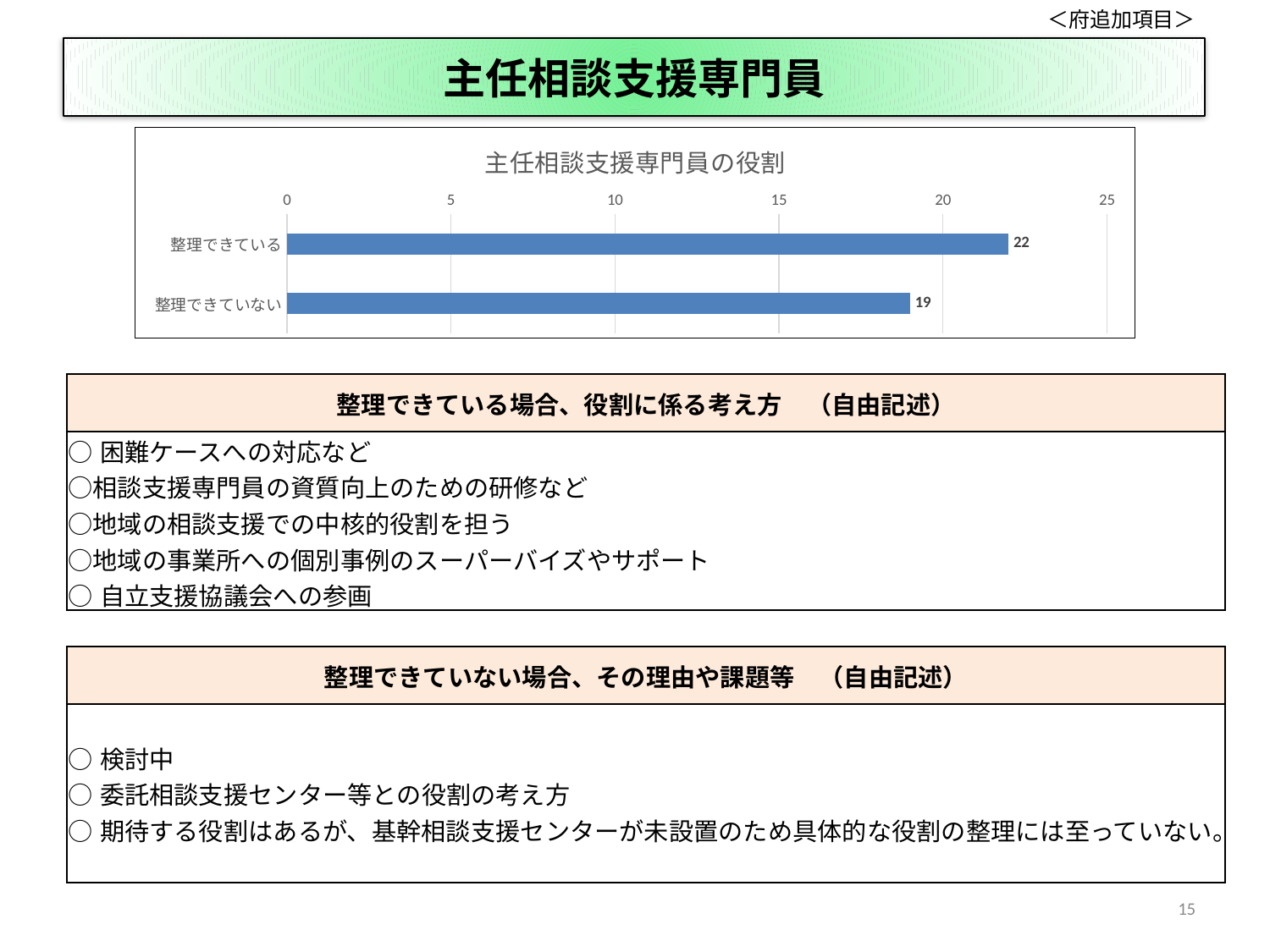
What is the value for 整理できている? 22 How many categories are shown in the chart? 2 What is the value for 整理できていない? 19 Is the value for 整理できていない greater or less than 20? less Which category has the lowest value? 整理できていない What is the difference between the values for 整理できている and 整理できていない? 3 Is the value for 整理できている greater or less than 20? greater What is the title of the chart? 主任相談支援専門員の役割 Which category has the highest value? 整理できている What kind of chart is shown on the slide? bar chart Which is larger, the value for 整理できている or 整理できていない? 整理できている What is the maximum value shown on the chart's axis? 25